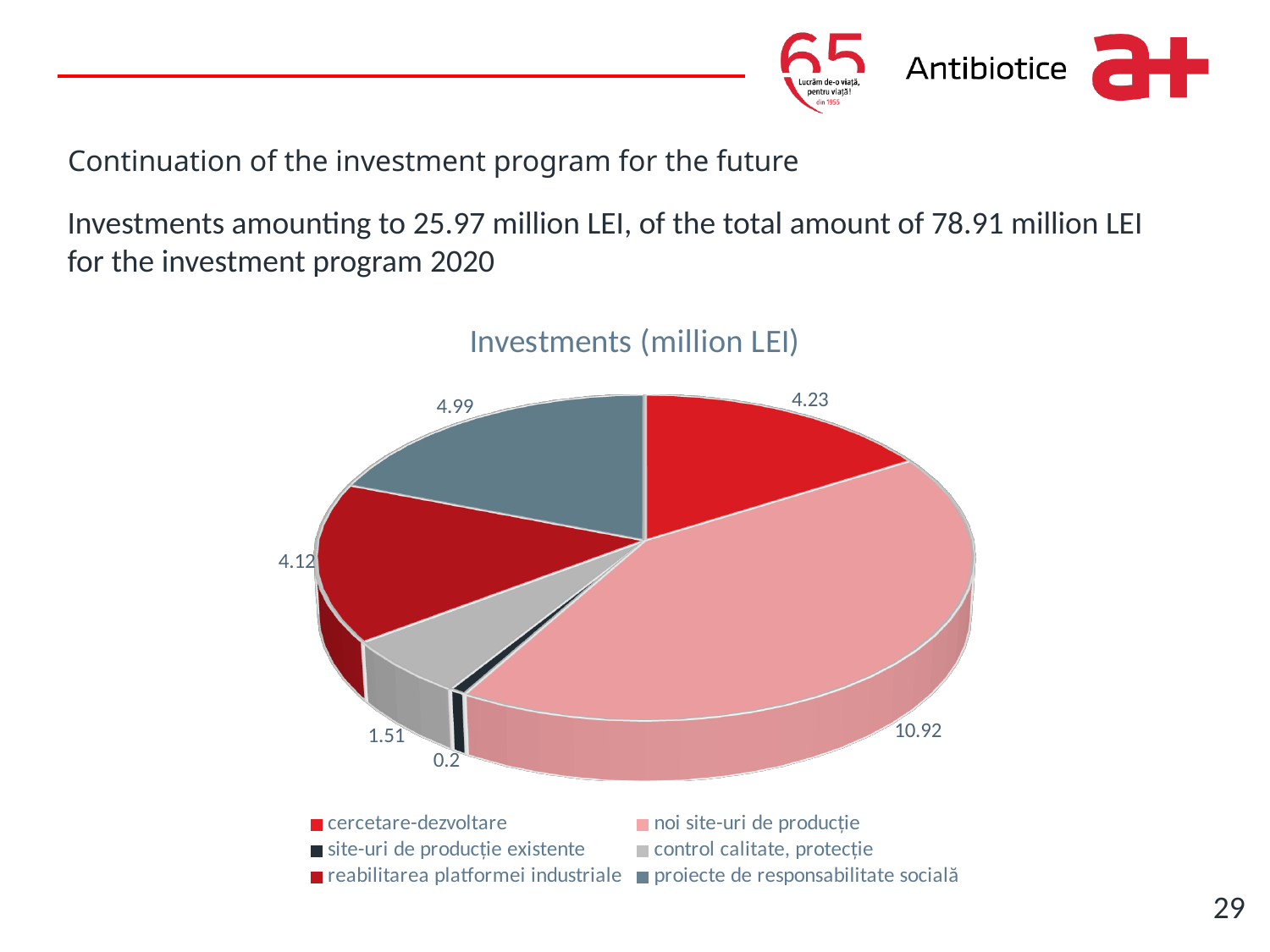
Which is larger, the value for reabilitarea platformei industriale or the value for control calitate, protecție? reabilitarea platformei industriale What is the value for proiecte de responsabilitate socială? 4.99 What is the total of all the slices in the pie chart? 25.97 How many categories does the pie chart have? 6 What type of chart is shown on the slide? pie chart What is the value for noi site-uri de producție? 10.92 What is the title of the chart? Investments (million LEI) Which category has the smallest slice of the pie? site-uri de producție existente What is the value for cercetare-dezvoltare? 4.23 What is the difference between the values for noi site-uri de producție and proiecte de responsabilitate socială? 5.93 What is the value for control calitate, protecție? 1.51 Which category has the largest slice of the pie? noi site-uri de producție